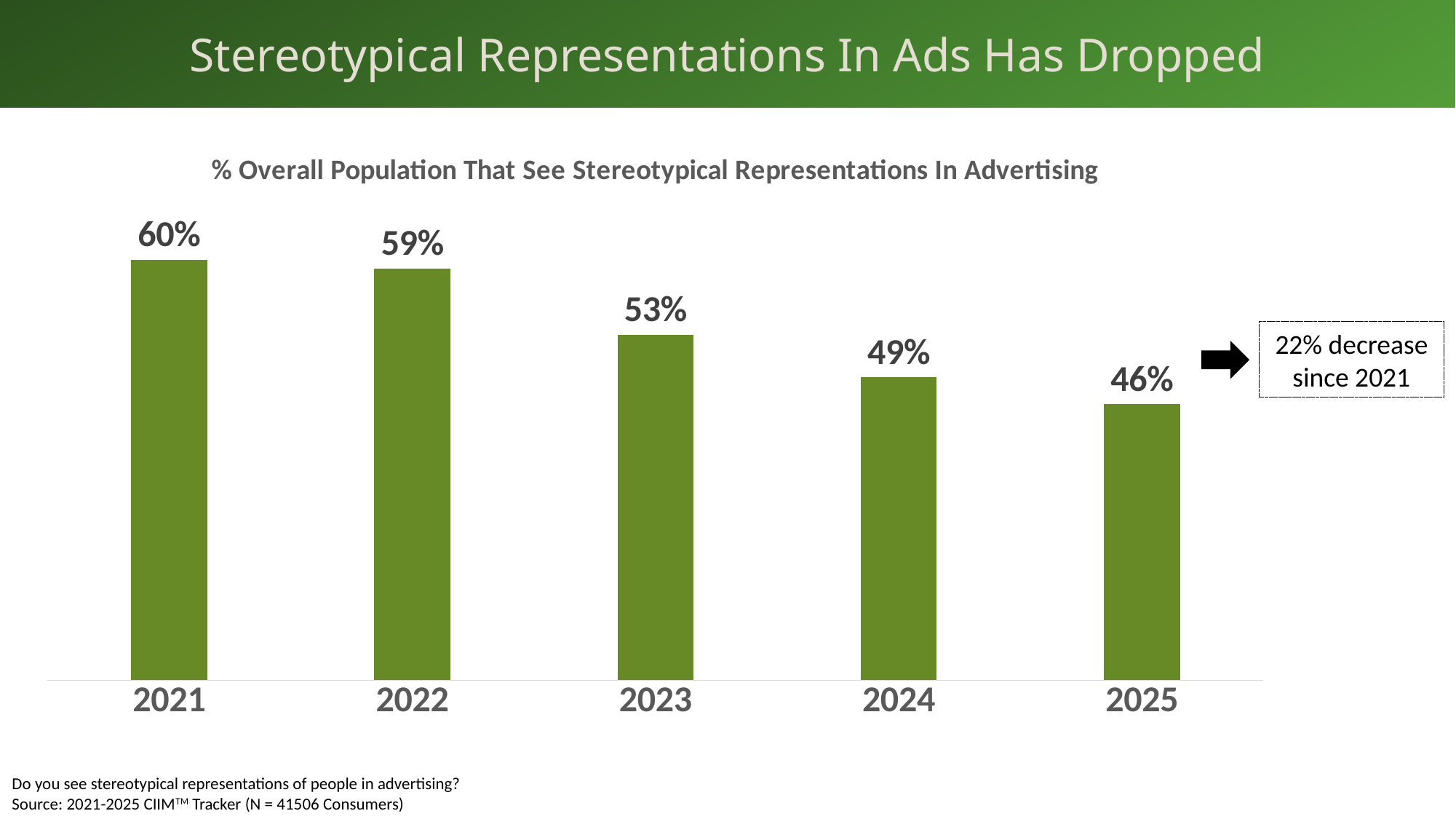
Do the values rise or fall from 2021 to 2025? Fall Which year has the highest value in the chart? 2021 What percentage of the overall population saw stereotypical representations in advertising in 2021? 60% What is the difference in percentage points between the 2022 and 2023 values? 6 percentage points Which year has a larger value, 2022 or 2024? 2022 What kind of chart is shown on the slide? Bar chart What is the value shown for 2025? 46% What is the title of the chart? % Overall Population That See Stereotypical Representations In Advertising How many years are shown on the x axis of the chart? 5 Which year has the lowest value in the chart? 2025 What is the value shown for 2023? 53% What is the difference in percentage points between the 2021 and 2025 values? 14 percentage points